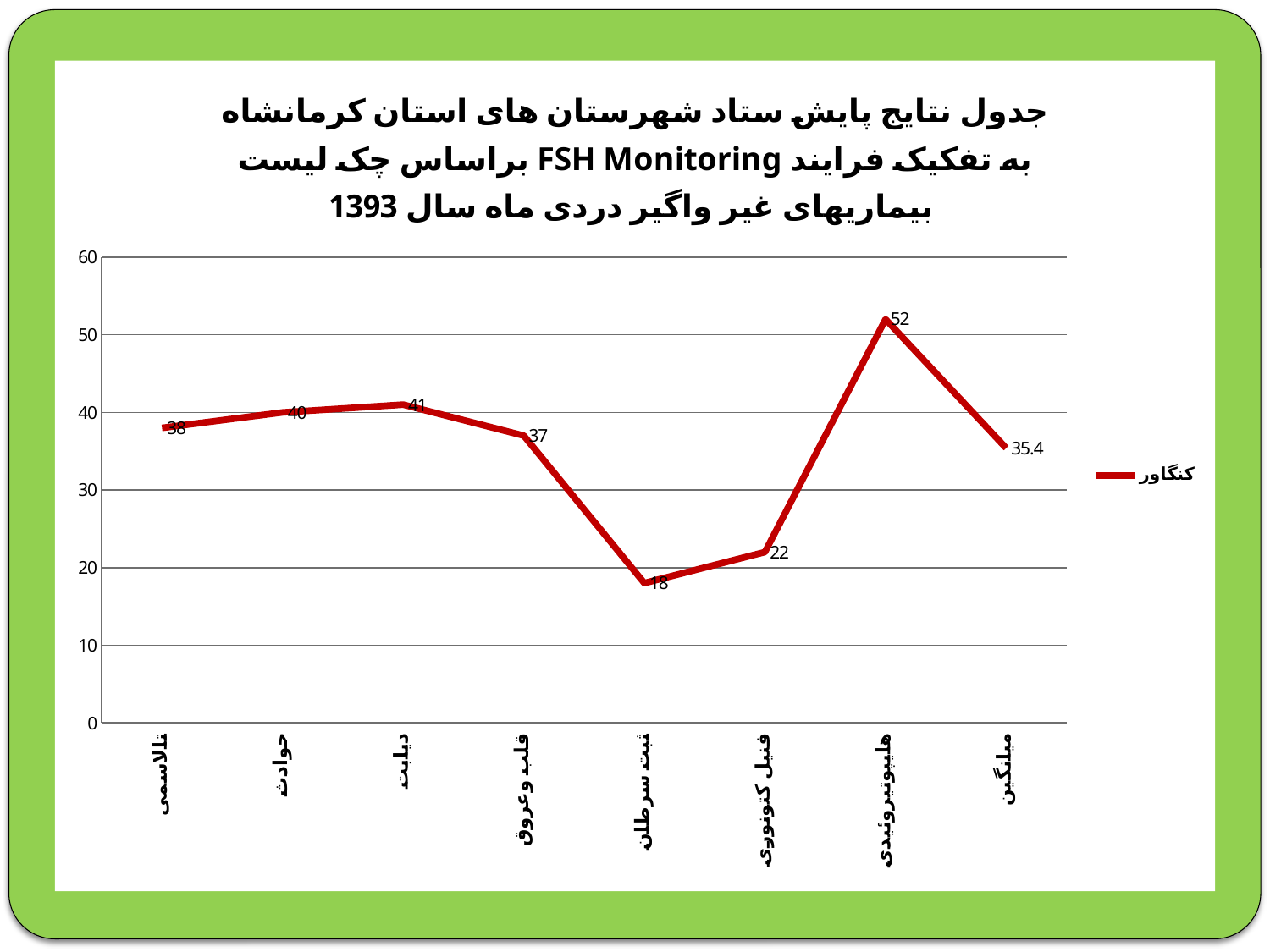
How many categories are shown on the x axis? 8 What is the value for میانگین? 35.4 What is the value for فنیل کتونوری? 22 What is the value for ثبت سرطان? 18 What is the difference between the values for هیپوتیروئیدی and ثبت سرطان? 34 Which is larger, the value for دیابت or the value for قلب و عروق? دیابت What is the value for تالاسمی? 38 Which category has the lowest value? ثبت سرطان Which category has the highest value? هایپوتیروئیدی What kind of chart is shown on the slide? line chart What series name does the legend show? کنگاور Is the value for حوادث greater or less than 30? greater